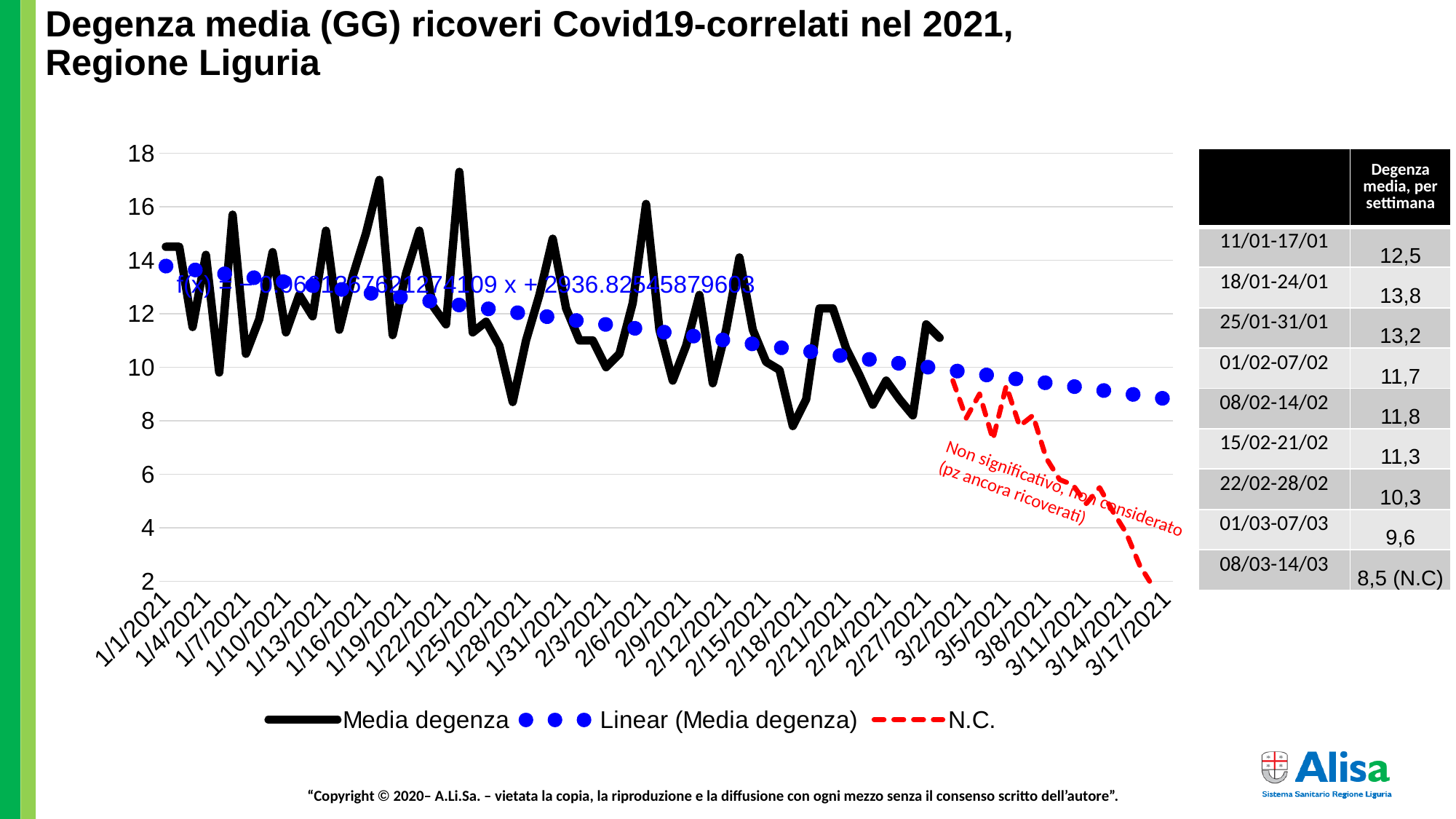
According to the table next to the chart, what is the Degenza media per settimana for 18/01-24/01? 13,8 How many series does the chart legend list? 3 What is the highest value shown on the y axis of the chart? 18 Does the blue dotted linear trend line rise or fall from left to right along the x axis? fall According to the table next to the chart, which week has the highest Degenza media per settimana? 18/01-24/01 What colour and style is the N.C. series drawn in? red dashed line Is the highest value of the Media degenza line (around 1/25/2021) greater or less than 16? greater What are the three entries in the chart legend? Media degenza, Linear (Media degenza), N.C. Is the N.C. dashed line value at 3/17/2021 greater or less than 4? less What kind of chart is shown on the slide? line chart